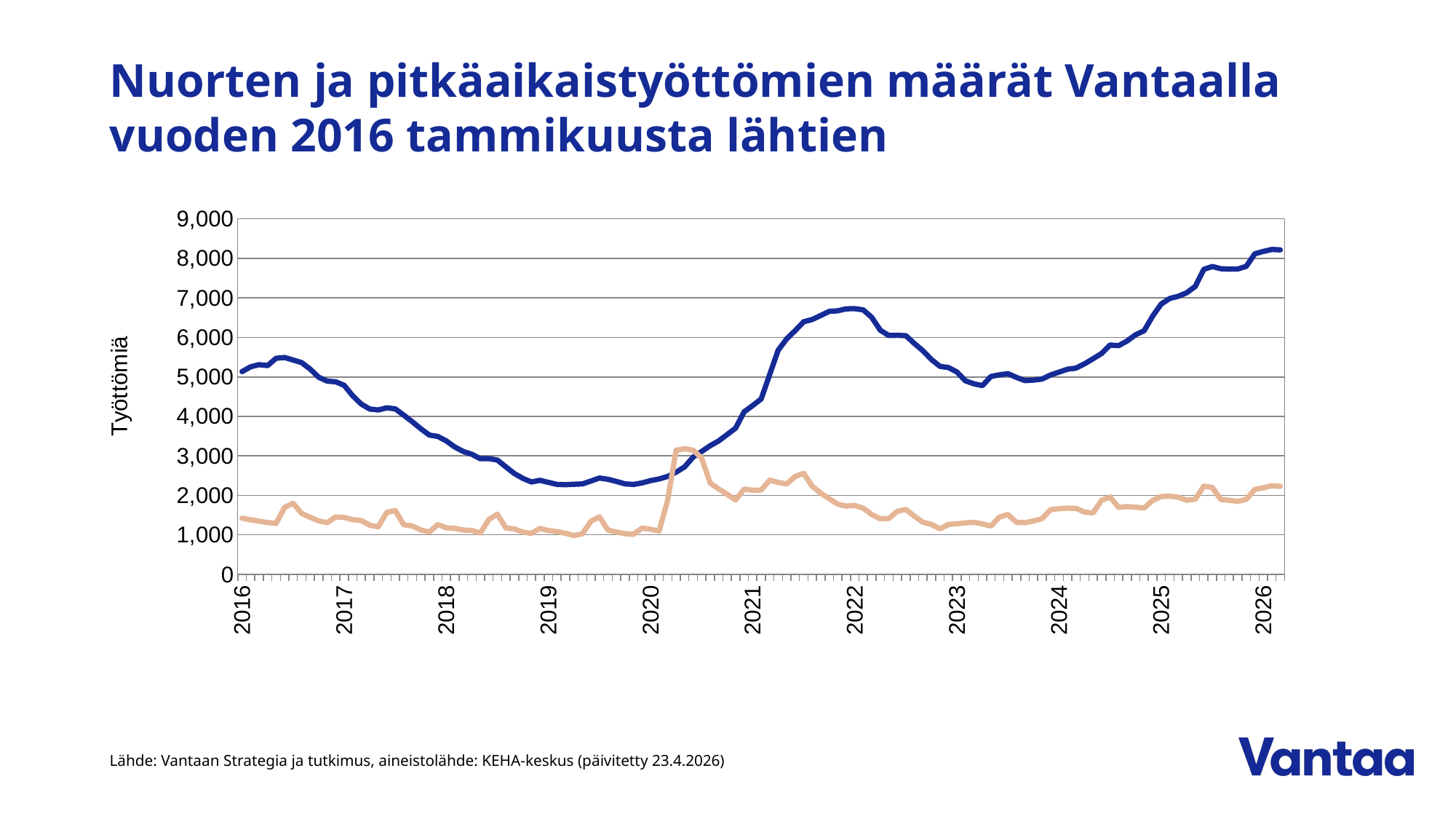
Is the value of the dark blue line at the start of 2022 greater or less than 6,000? greater Does the dark blue line rise or fall between 2023 and 2026? rise Which line is higher at the start of 2022, the dark blue line or the light orange line? the dark blue line What kind of chart is shown on the slide? line chart Is the value of the dark blue line at the start of 2026 greater or less than 8,000? greater Is the value of the dark blue line at the start of 2024 greater or less than 6,000? less Does the dark blue line rise or fall between 2016 and 2019? fall What is the title of the y axis? Työttömiä How many lines are plotted on the chart? 2 What is the highest value shown on the y axis? 9,000